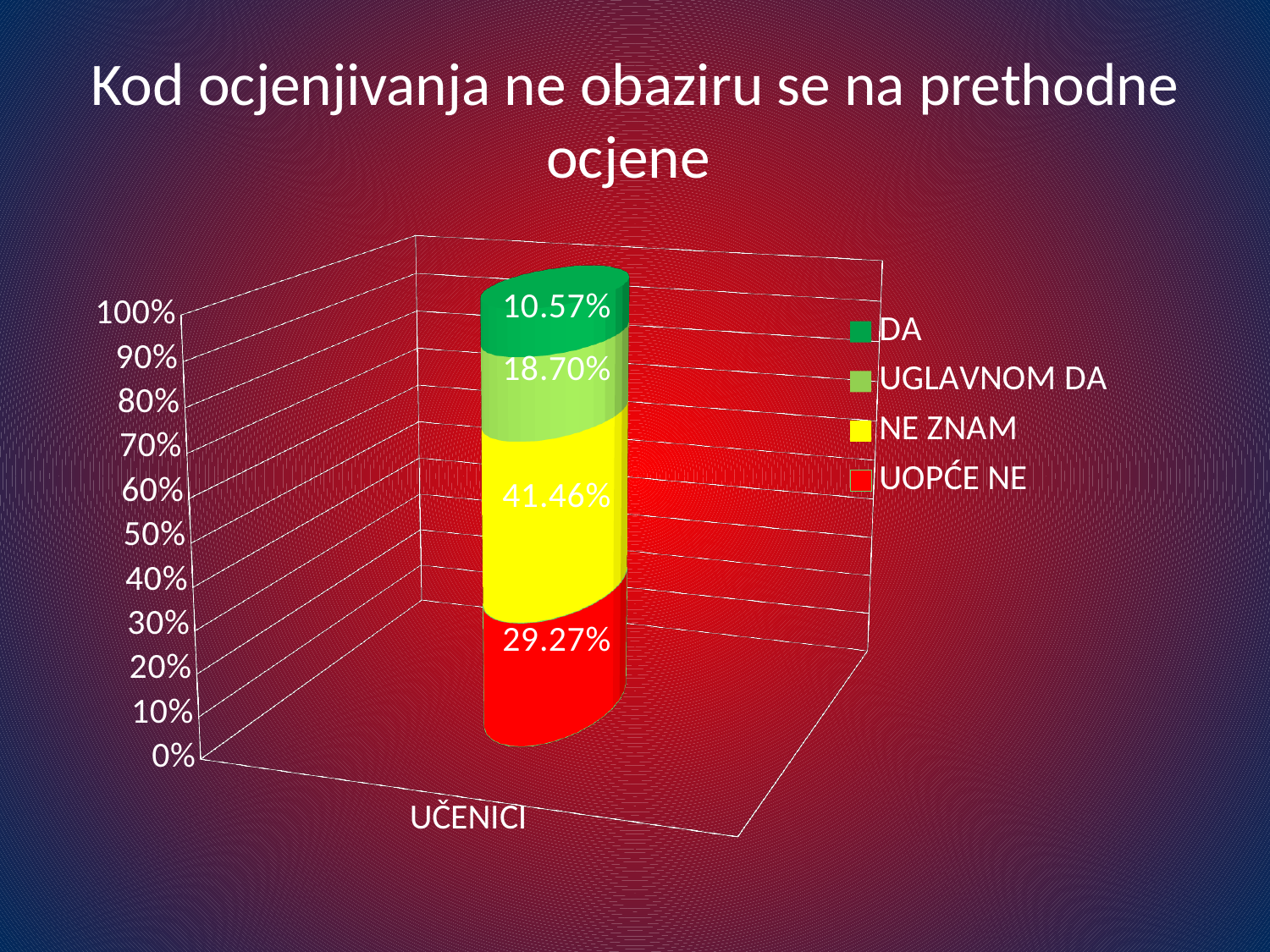
What is the difference between the NE ZNAM and UOPĆE NE values? 12.19% What is the title of the chart? Kod ocjenjivanja ne obaziru se na prethodne ocjene How many series does the legend list? 4 What is the value for DA in the UČENICI bar? 10.57% What kind of chart is shown on the slide? Stacked bar chart Which series has the largest share in the UČENICI bar? NE ZNAM Which is larger, the value for UGLAVNOM DA or the value for UOPĆE NE? UOPĆE NE What is the value for UOPĆE NE in the UČENICI bar? 29.27% Which series has the smallest share in the UČENICI bar? DA What is the value for NE ZNAM in the UČENICI bar? 41.46% How many categories are shown on the x axis? 1 What is the value for UGLAVNOM DA in the UČENICI bar? 18.70%